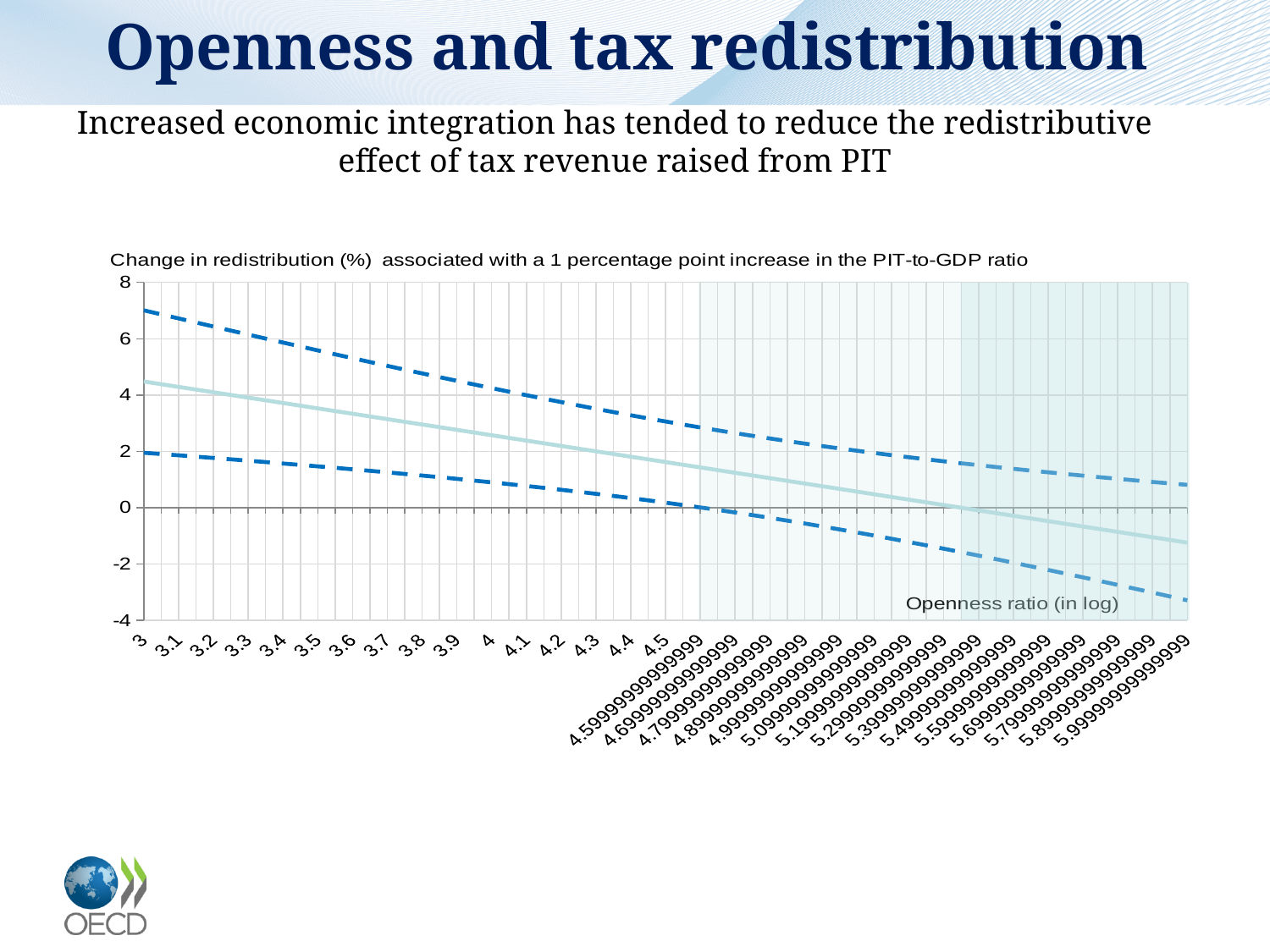
Is the value of the solid line at an openness ratio of 4 greater or less than 2? greater What is the label shown for the x axis of the chart? Openness ratio (in log) What kind of chart is shown on the slide? line chart What is the highest value shown on the y axis of the chart? 8 Is the solid line's value larger at an openness ratio of 3 or at 5.9999999999999? 3 Is the value of the lower dashed line at the right end of the x axis (5.9999999999999) greater or less than -2? less Does the solid line fall or rise as the openness ratio increases along the x axis? falls At an openness ratio of 3, which is larger: the upper dashed line or the solid line? the upper dashed line Is the value of the upper dashed line at an openness ratio of 3 greater or less than 6? greater